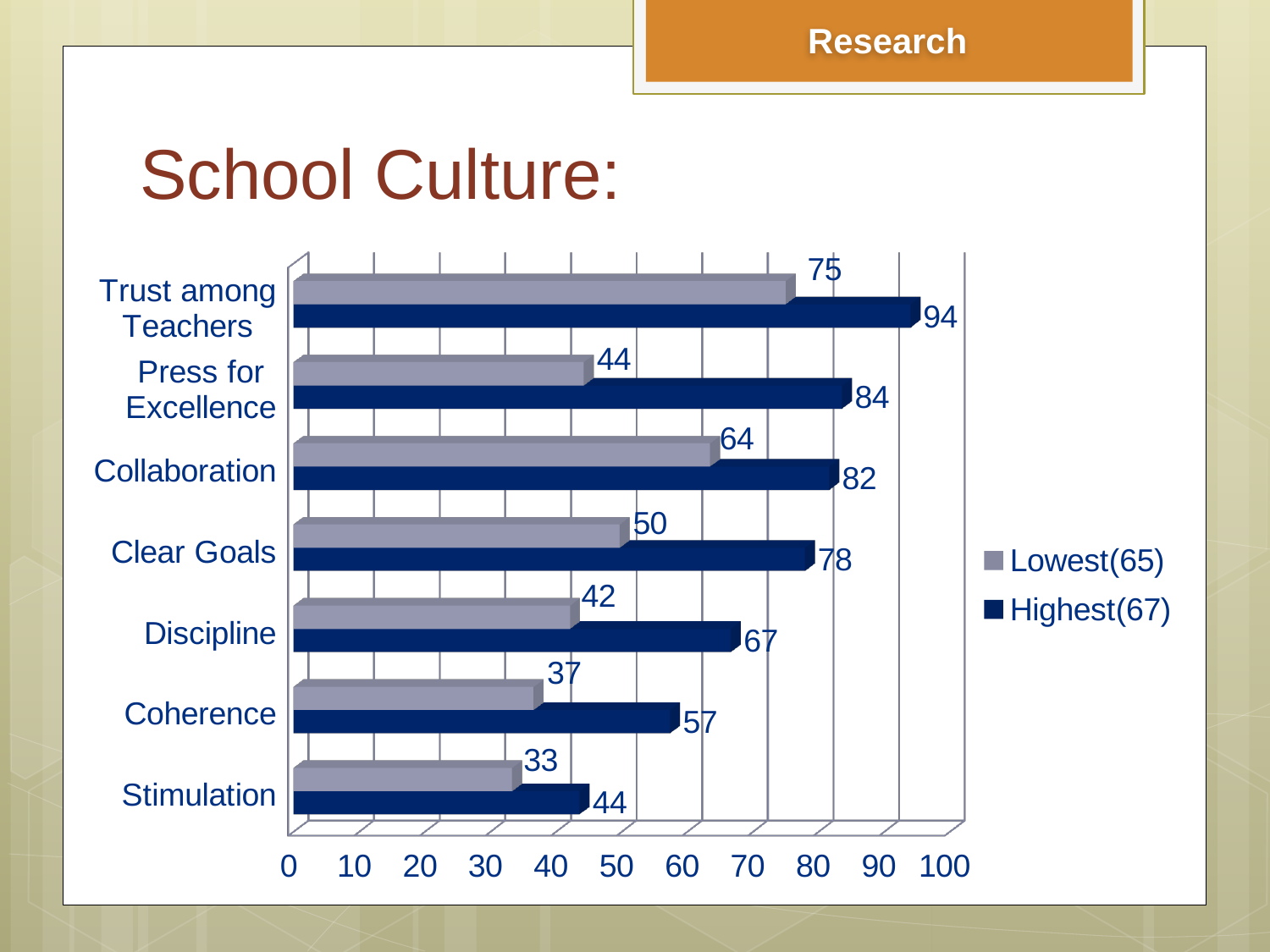
What is the title of the slide containing the chart? School Culture: What is the difference between the Highest(67) and Lowest(65) values for Press for Excellence? 40 What kind of chart is shown on the slide? Bar chart How many categories are shown on the chart? 7 Which category has the lowest Highest(67) value? Stimulation How many series does the legend list? 2 What is the Lowest(65) value for Press for Excellence? 44 What is the Highest(67) value for Trust among Teachers? 94 Which category has the highest Lowest(65) value? Trust among Teachers Which is larger: the Lowest(65) value for Collaboration or the Lowest(65) value for Clear Goals? Collaboration What is the Highest(67) value for Discipline? 67 What is the difference between the Highest(67) values for Collaboration and Coherence? 25